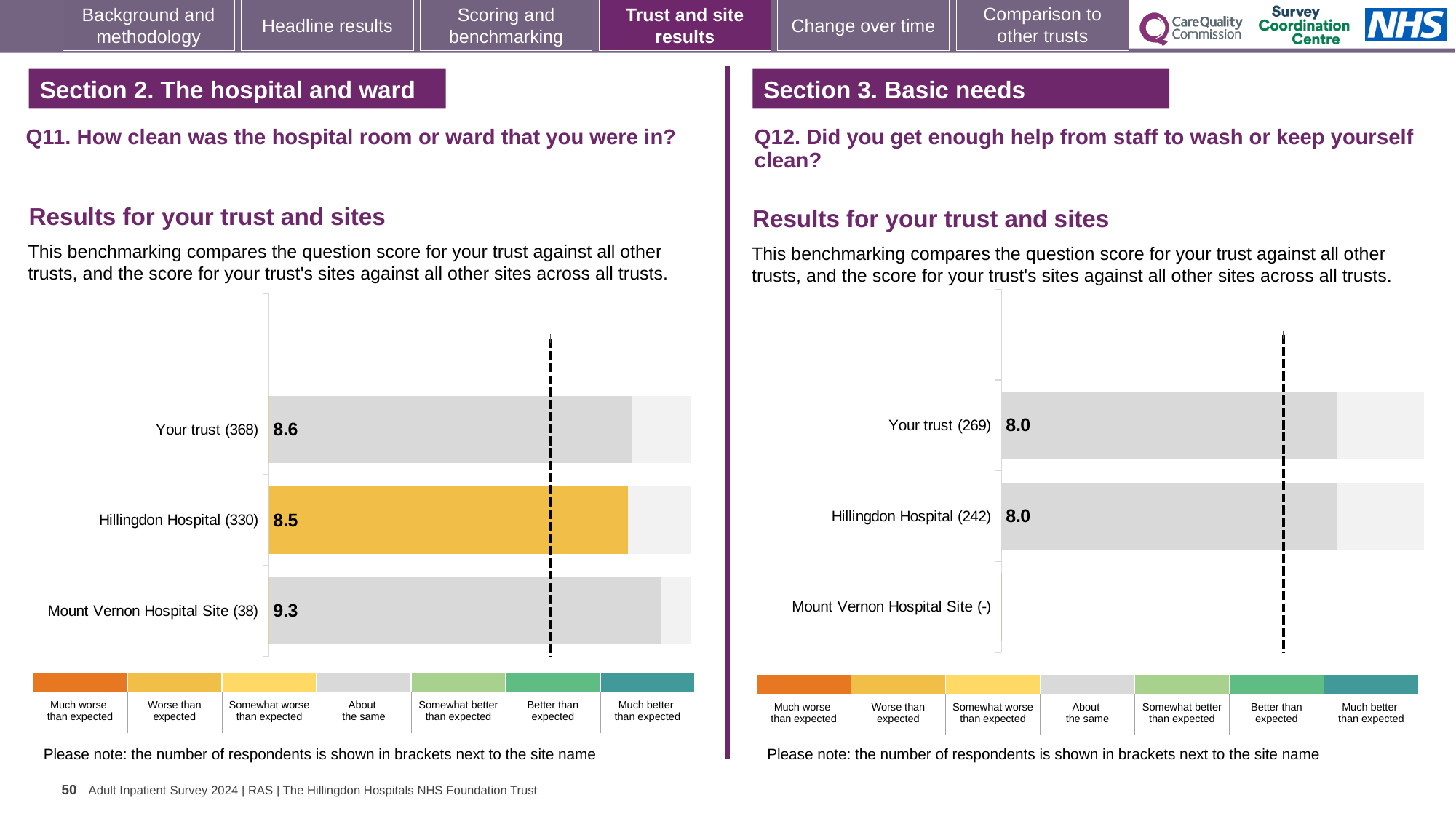
In the Q12 chart on the right, what is the score for Hillingdon Hospital (242)? 8.0 In the Q11 chart on the left, what is the score for Mount Vernon Hospital Site (38)? 9.3 In the Q11 chart on the left, which site or trust has the lowest score? Hillingdon Hospital (330) In the Q11 chart on the left, which site or trust has the highest score? Mount Vernon Hospital Site (38) In the Q11 chart on the left, what is the score for Your trust (368)? 8.6 In the Q12 chart on the right, what is the score for Your trust (269)? 8.0 In the Q11 chart on the left, which benchmark category does the colour of the Hillingdon Hospital (330) bar correspond to? Worse than expected In the Q11 chart on the left, what is the score for Hillingdon Hospital (330)? 8.5 In the Q11 chart on the left, what is the difference between the scores for Mount Vernon Hospital Site (38) and Hillingdon Hospital (330)? 0.8 What kind of chart is used for the Q11 results on the left? Bar chart In the Q12 chart on the right, how many respondents are shown for Mount Vernon Hospital Site? - How many categories (rows) are shown in the Q11 chart on the left? 3